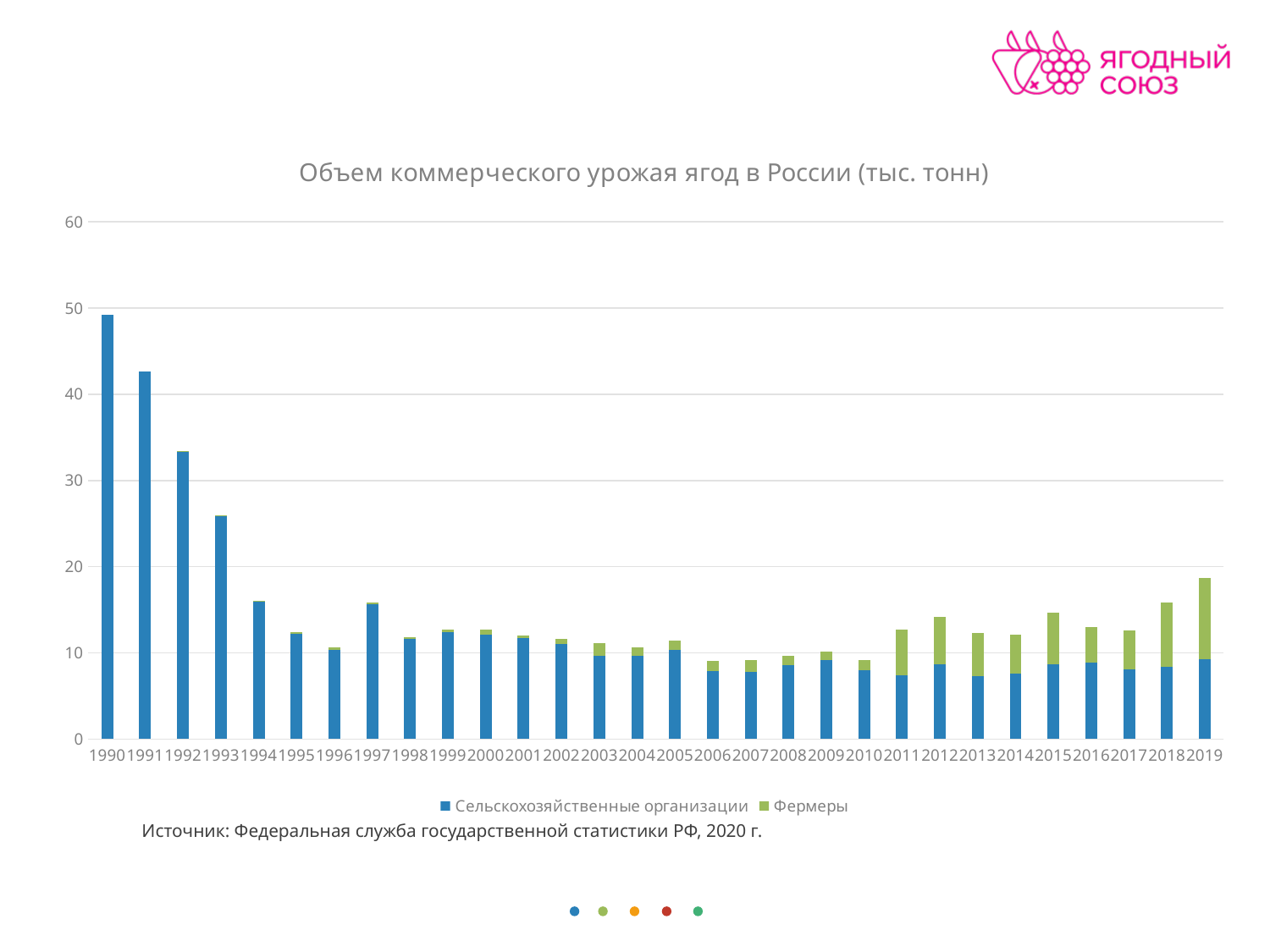
Which year has the highest total commercial berry harvest? 1990 Is the total value for 2019 greater or less than 20? less Do the values rise or fall from 1990 to 1993? fall Which series is shown in green in the legend? Фермеры Is the value for 1992 greater or less than 30? greater How many years are shown on the x axis? 30 How many series does the legend list? 2 Which year has the larger total, 2018 or 2019? 2019 What is the title of the chart? Объем коммерческого урожая ягод в России (тыс. тонн) Is the value for 1990 greater or less than 40? greater What kind of chart is shown on the slide? bar chart